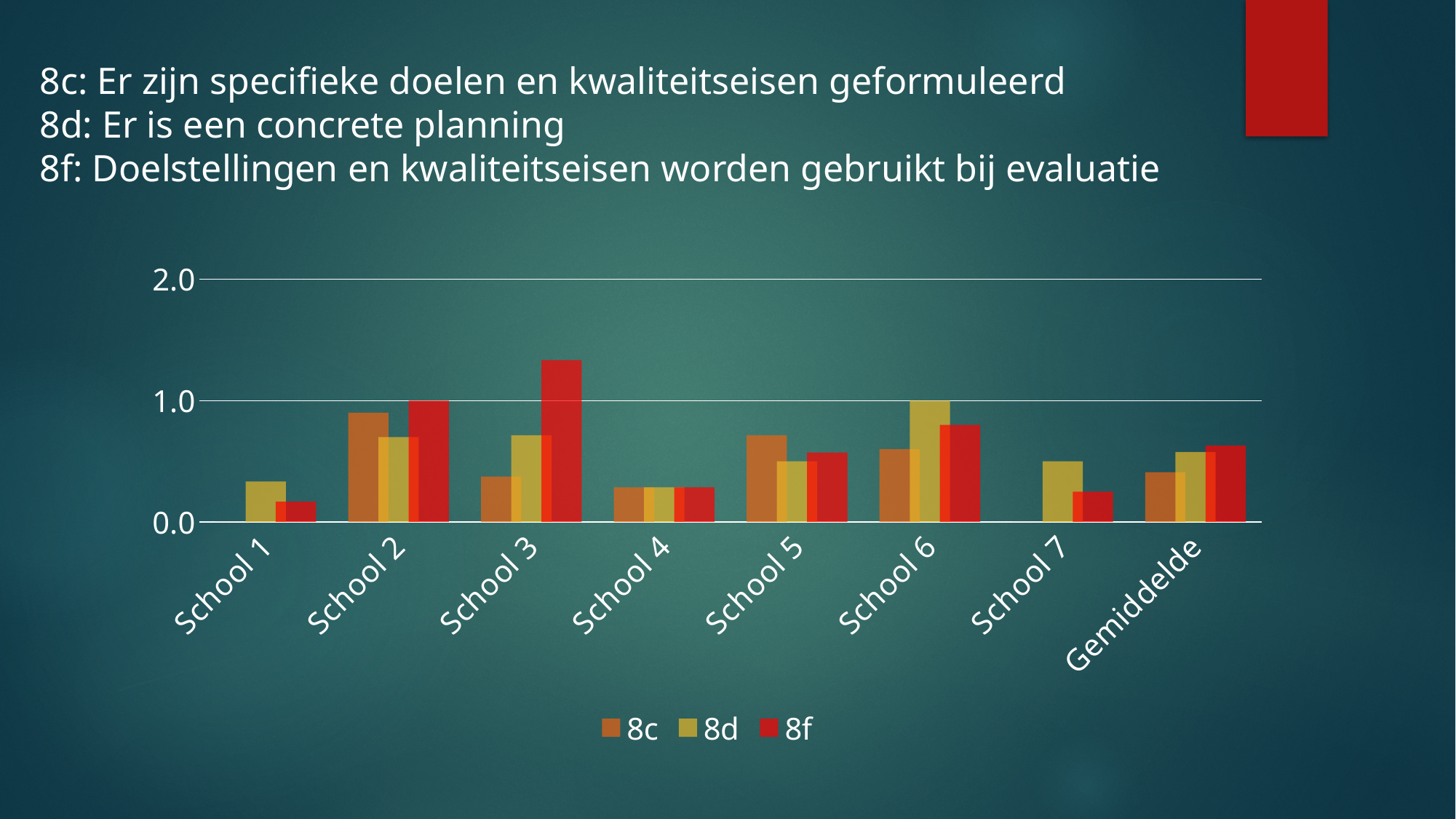
How many categories are shown on the x axis? 8 Which series has the tallest bar in the whole chart? 8f Which is larger: the 8c value for School 2 or the 8c value for School 4? School 2 At School 3, which is larger: the 8f value or the 8c value? 8f What is the label of the last category on the x axis? Gemiddelde Is the value for 8c at School 4 greater or less than 1.0? less Is the value for 8d at School 1 greater or less than 1.0? less How many series does the legend list? 3 What are the three legend entries of the chart? 8c, 8d, 8f Is the value for 8f at School 3 greater or less than 1.0? greater What kind of chart is shown on the slide? bar chart Which school has the highest value for series 8f? School 3